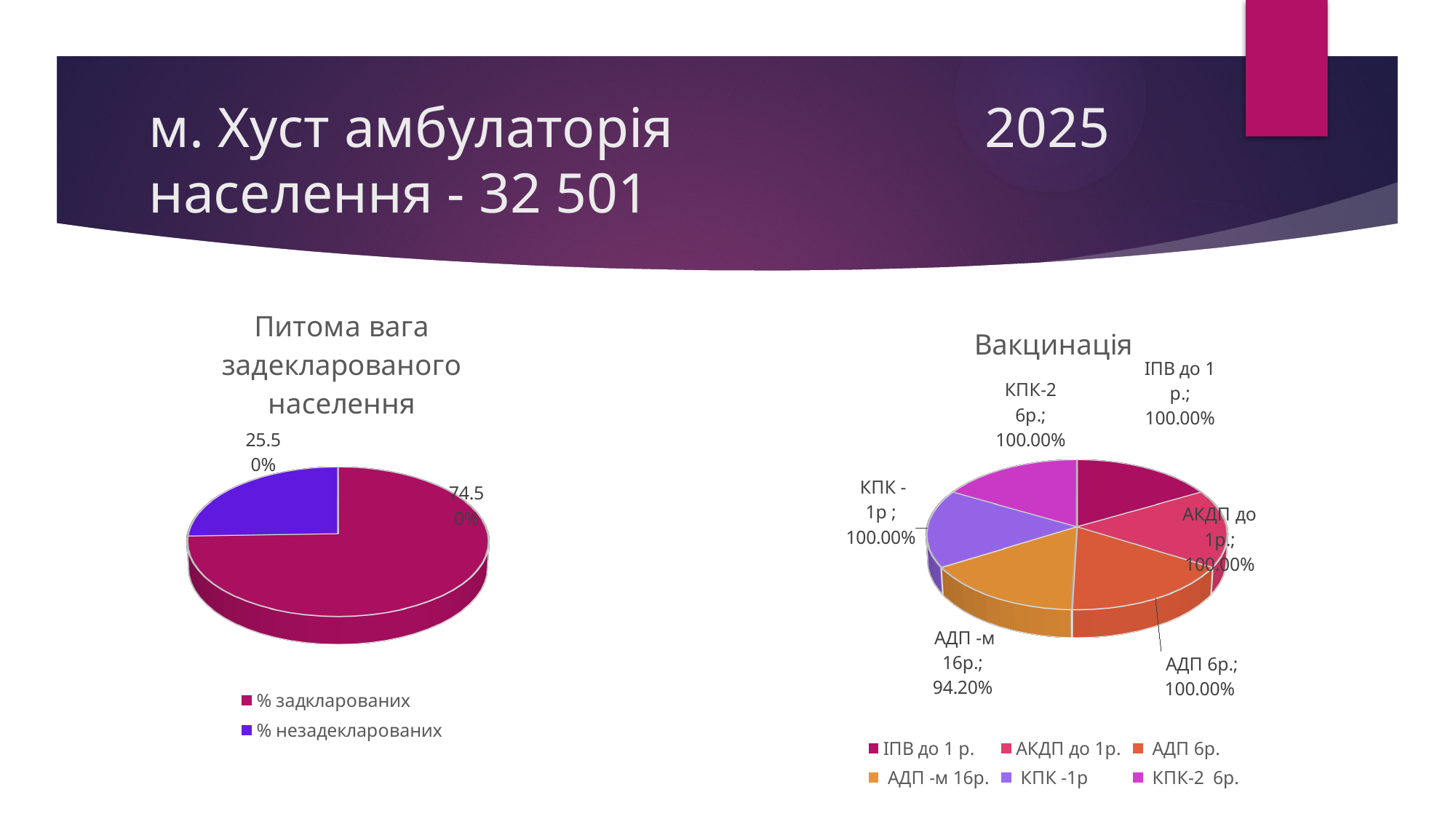
In the right pie chart (Вакцинація), how many categories are shown? 6 In the left pie chart (Питома вага задекларованого населення), what is the value for % незадекларованих? 25.50% In the right pie chart (Вакцинація), which category has the lowest value? АДП -м 16р. In the right pie chart (Вакцинація), how many entries does the legend list? 6 In the right pie chart (Вакцинація), what is the difference between the values for КПК -1р and АДП -м 16р.? 5.80% In the left pie chart (Питома вага задекларованого населення), how many slices are there? 2 In the left pie chart (Питома вага задекларованого населення), what is the value for % задкларованих? 74.50% In the left pie chart (Питома вага задекларованого населення), which slice is larger: % задкларованих or % незадекларованих? % задкларованих What kind of chart is the left chart (Питома вага задекларованого населення)? Pie chart In the right pie chart (Вакцинація), what is the value for АДП -м 16р.? 94.20% What is the title of the right chart? Вакцинація In the right pie chart (Вакцинація), what is the value for ІПВ до 1 р.? 100.00%